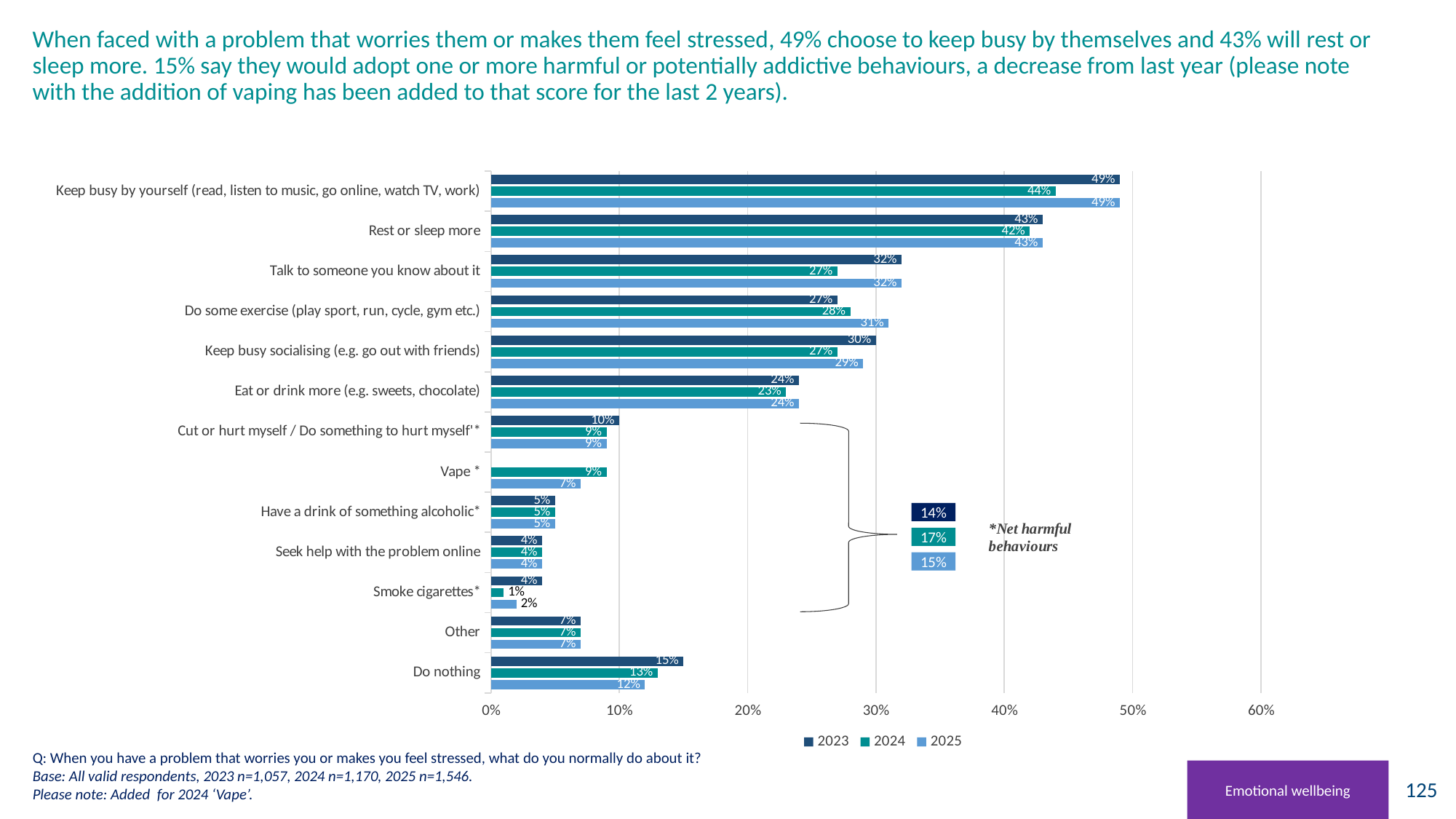
What is the difference between the 2025 and 2024 values for 'Talk to someone you know about it'? 5% What is the 2023 value for 'Do nothing'? 15% What is the 2024 value for 'Rest or sleep more'? 42% Which category has the lowest 2024 value? Smoke cigarettes* How many categories are shown on the chart? 13 How many series does the legend list? 3 What is the 2025 value for 'Keep busy by yourself (read, listen to music, go online, watch TV, work)'? 49% What is the 2024 value for 'Smoke cigarettes*'? 1% Which is larger for 'Do some exercise (play sport, run, cycle, gym etc.)': the 2023 value or the 2025 value? 2025 What kind of chart is shown on the slide? Bar chart Which category has the highest 2025 value? Keep busy by yourself (read, listen to music, go online, watch TV, work) What is the 2024 value shown for '*Net harmful behaviours'? 17%